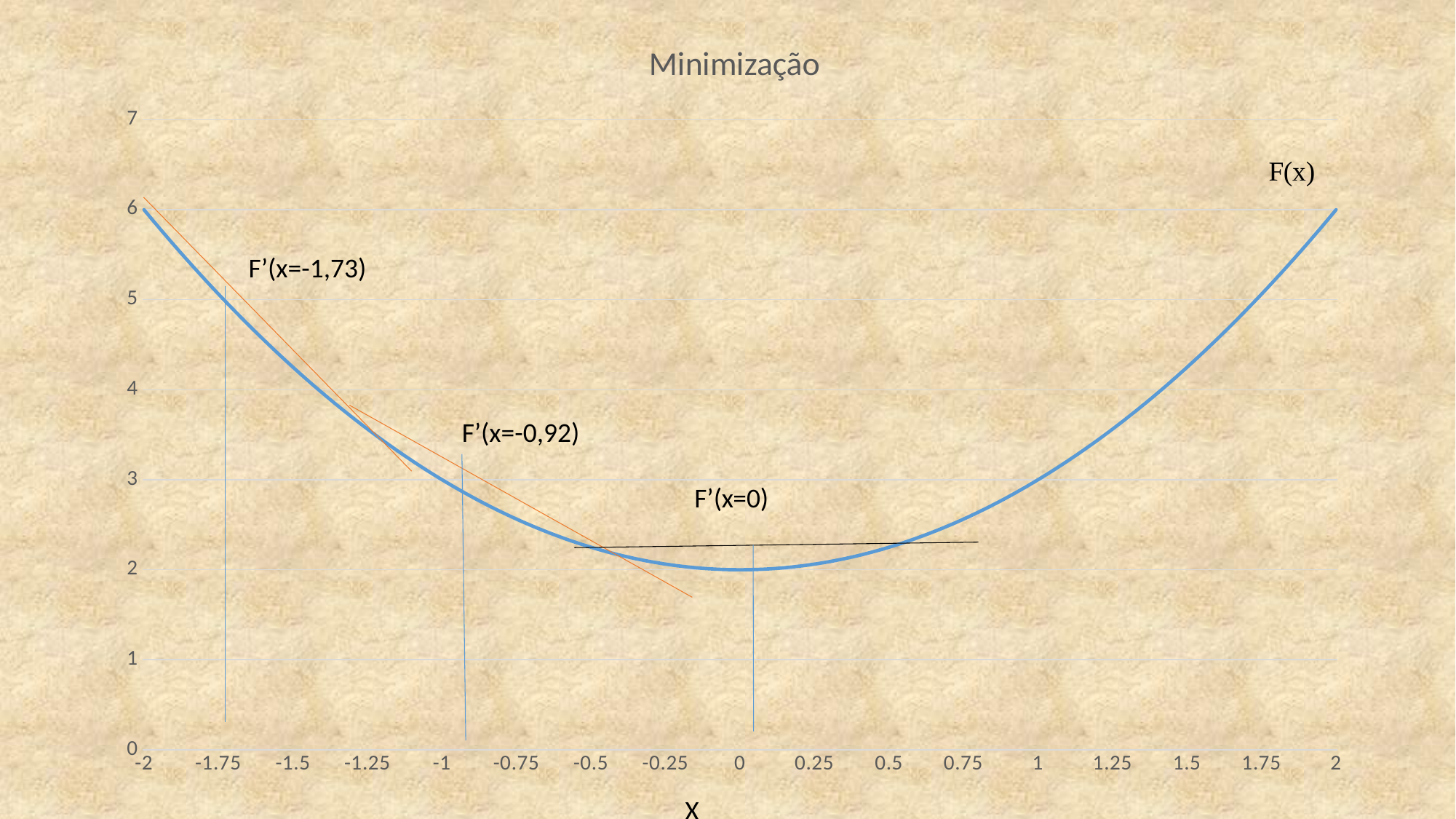
Is the value of F(x) at x = -1.5 greater or less than 4? greater Does the curve F(x) rise or fall as x goes from -2 to 0? fall What is the value of F(x) at x = 2? 6 What is the value of F(x) at x = -2? 6 What is the value of F(x) at x = 0? 2 Does the curve F(x) rise or fall as x goes from 0 to 2? rise At which x value does the curve F(x) reach its lowest point? 0 What is the label of the x axis? X Which is larger, F(x) at x = -1 or F(x) at x = 0? F(x) at x = -1 What is the title of the chart? Minimização What kind of chart is shown on the slide? line chart Is the value of F(x) at x = 1 greater or less than 4? less